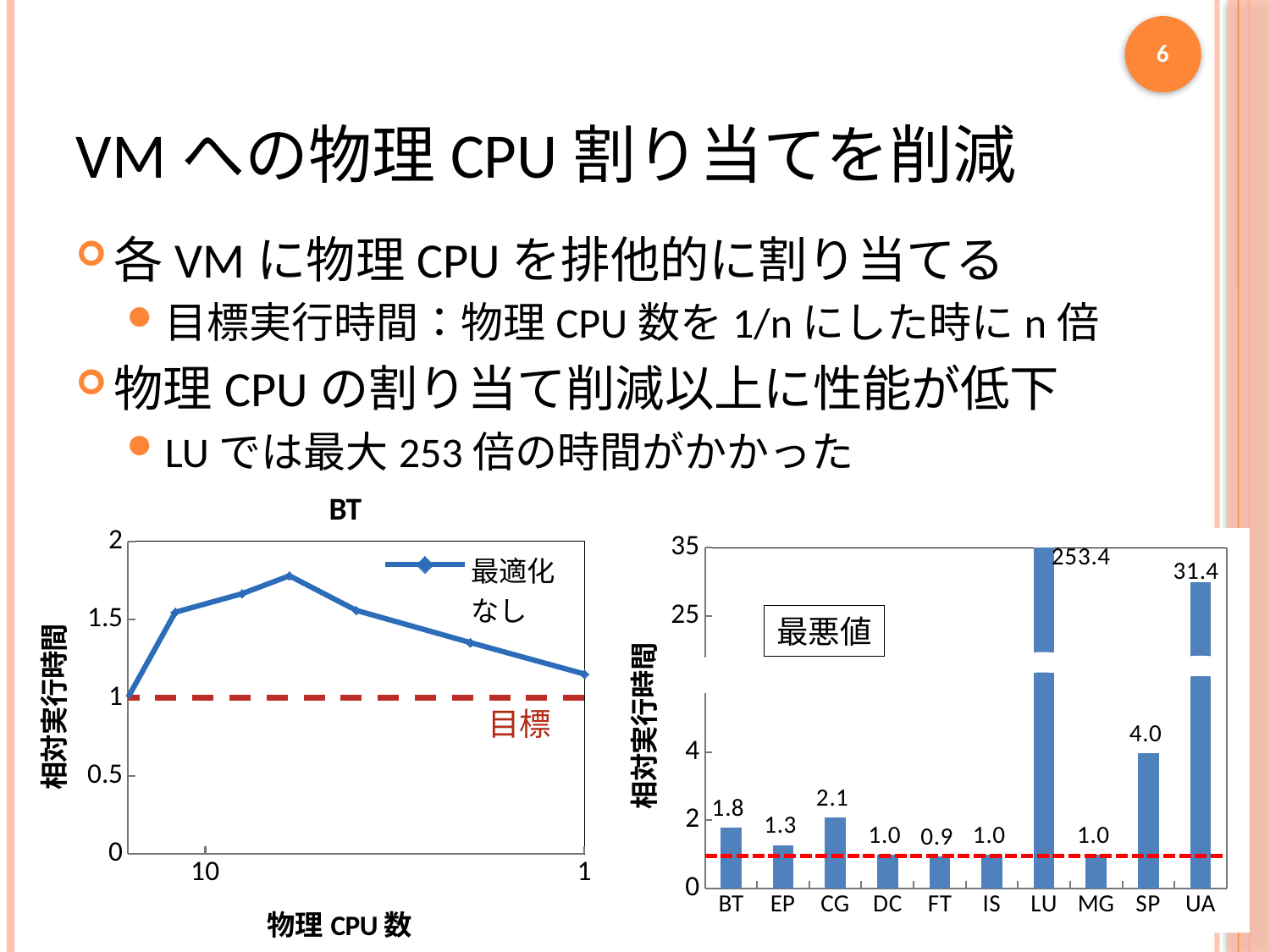
In the bar chart on the right, how many categories are shown on the x axis? 10 In the bar chart on the right, which category has the highest value? LU In the bar chart on the right, what is the difference between the values for UA and SP? 27.4 In the bar chart on the right, which is larger, the value for BT or the value for EP? BT In the line chart on the left titled BT, what is the legend entry for the plotted line? 最適化なし In the line chart on the left titled BT, is the value at the rightmost point (1 physical CPU) greater or less than 1.5? less In the bar chart on the right, what is the value for UA? 31.4 In the bar chart on the right, what is the value for LU? 253.4 In the bar chart on the right, what is the value for SP? 4.0 What kind of chart is the chart on the left titled BT? line chart In the bar chart on the right, what is the value for CG? 2.1 In the bar chart on the right, which category has the lowest value? FT